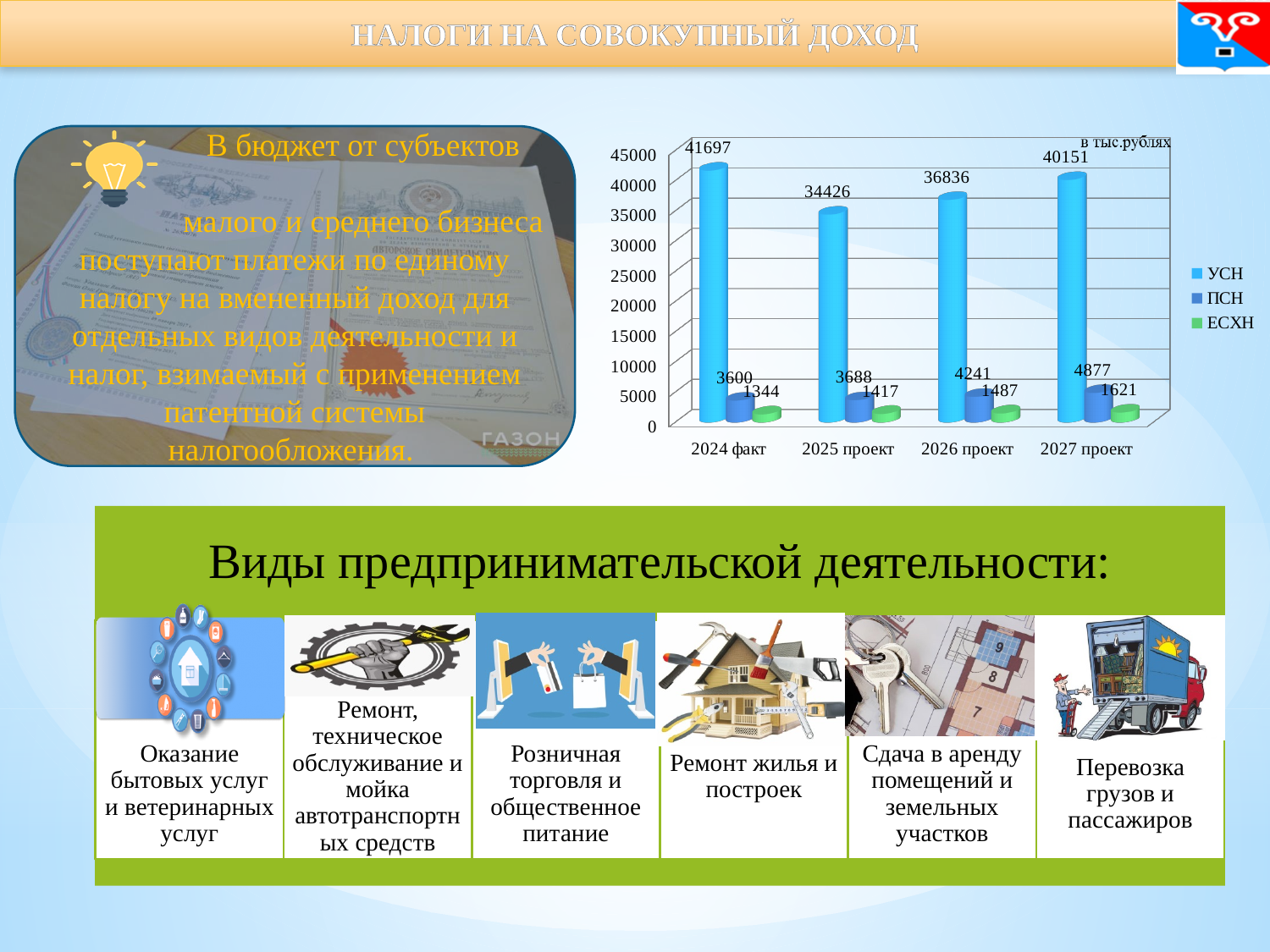
What kind of chart is shown? bar chart What is the value for УСН in 2024 факт? 41697 Is the УСН value for 2027 проект greater or less than 35000? greater In which year is the УСН value lowest? 2025 проект What is the value for ПСН in 2027 проект? 4877 How many year categories are shown on the x axis? 4 What is the difference between the УСН values for 2024 факт and 2025 проект? 7271 Which is larger, the ПСН value in 2026 проект or the ПСН value in 2025 проект? 2026 проект Do the ЕСХН values rise or fall from 2024 факт to 2027 проект? rise How many series does the legend list? 3 In which year is the ПСН value highest? 2027 проект What is the value for ЕСХН in 2025 проект? 1417